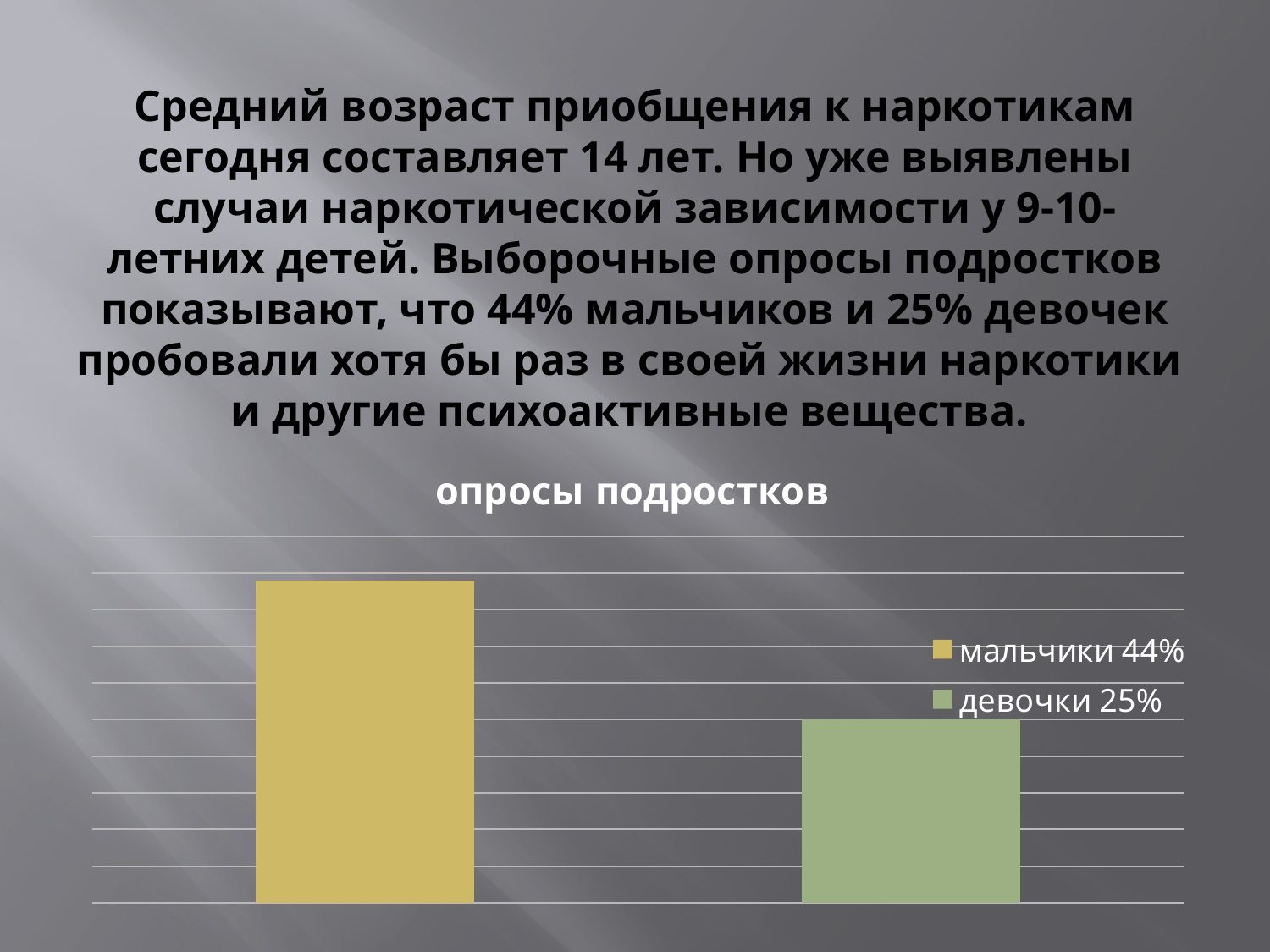
What is the title of the chart? опросы подростков What percentage is shown in the legend for мальчики? 44% What percentage is shown in the legend for девочки? 25% What colour is the bar for мальчики? yellow Which series has the lowest bar in the chart? девочки What is the difference between the percentages shown for мальчики and девочки? 19% What kind of chart is shown on the slide? bar chart Which series has the highest bar in the chart? мальчики How many bars are plotted in the chart? 2 How many entries does the chart legend list? 2 Which series has the taller bar, мальчики or девочки? мальчики